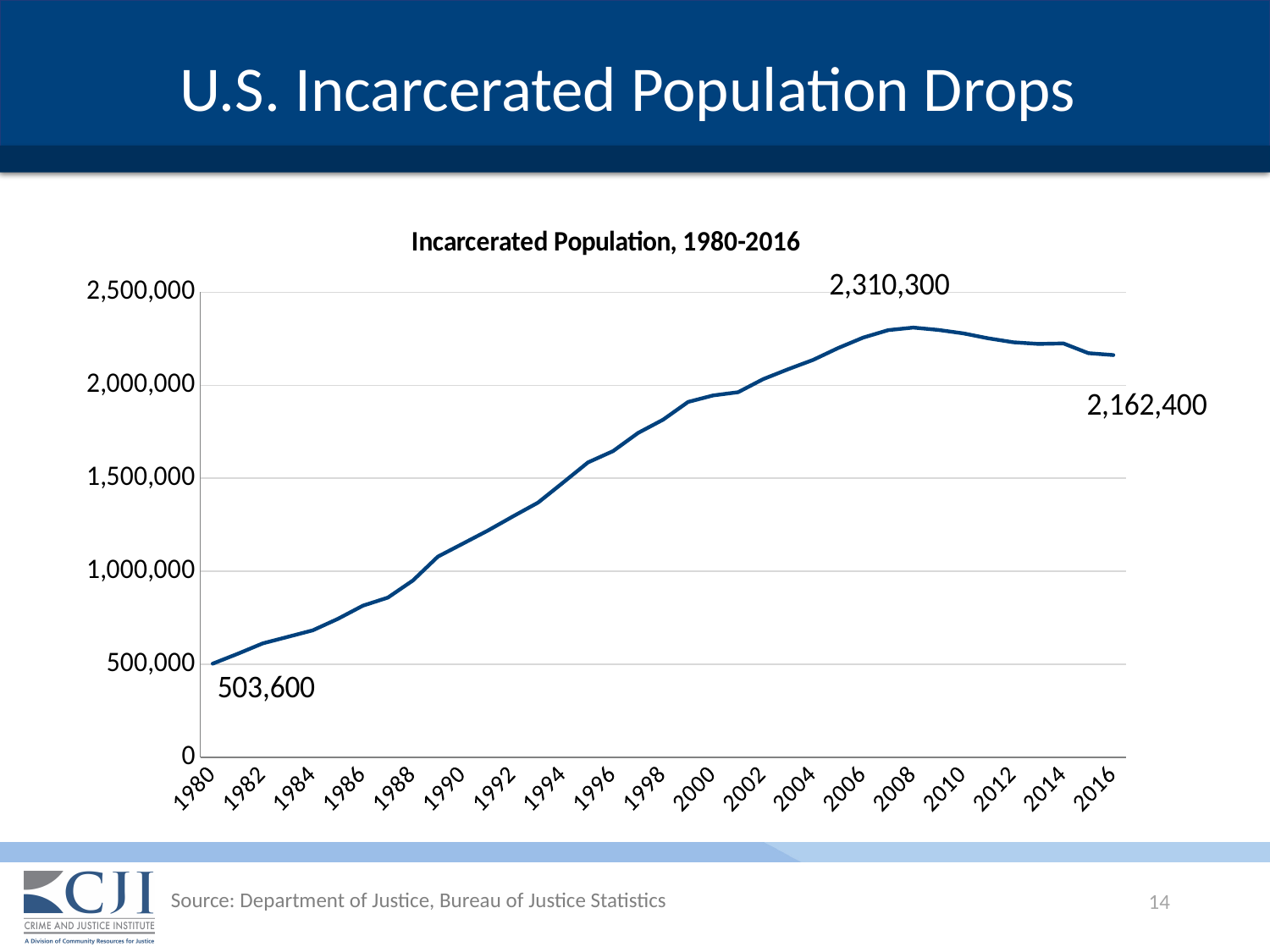
Which year has the larger incarcerated population, 1980 or 2016? 2016 How much lower is the 2016 value than the peak value of 2,310,300? 147,900 What is the incarcerated population shown for 1980? 503,600 What is the incarcerated population shown for 2016? 2,162,400 Is the value for 2000 greater or less than 1,500,000? greater What is the difference between the 2016 value and the 1980 value? 1,658,800 What is the highest value labelled on the line? 2,310,300 What kind of chart is shown on the slide? line chart Is the value for 1990 greater or less than 1,000,000? greater In which year does the incarcerated population reach its lowest point? 1980 Does the incarcerated population rise or fall between 2008 and 2016? fall Is the value for 1986 greater or less than 1,000,000? less